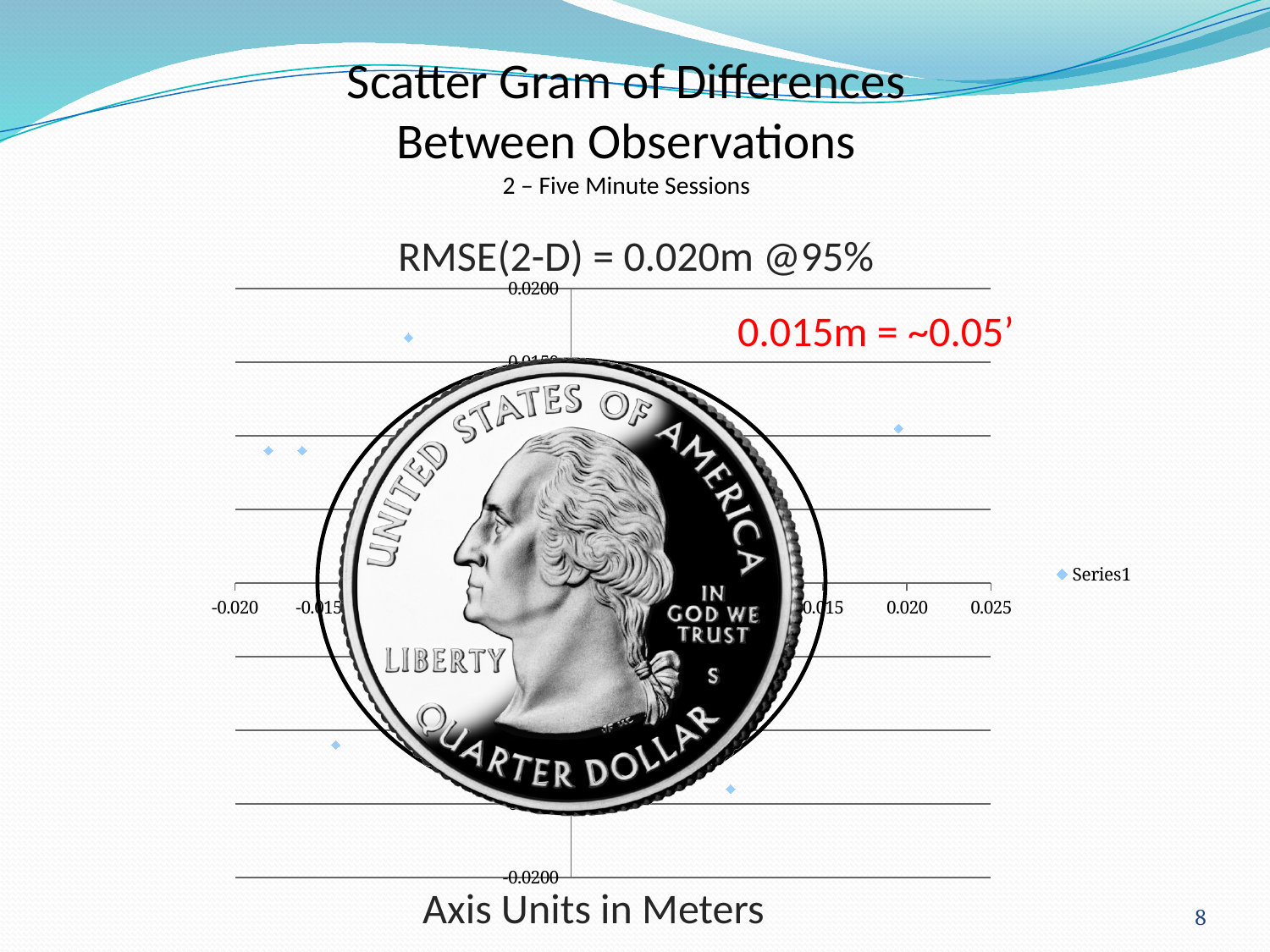
What is the largest value labelled on the chart's x axis? 0.025 How many series does the chart legend list? 1 What is the lowest value labelled on the chart's y axis? -0.0200 What kind of chart is shown on the slide? scatter chart Is the highest plotted point in the chart above or below 0.0150 on the y axis? above What is the highest value labelled on the chart's y axis? 0.0200 Is the lowest plotted point in the chart above or below -0.0200 on the y axis? above What is the title of the chart? RMSE(2-D) = 0.020m @95% Is the rightmost plotted point in the chart to the left or right of 0.015 on the x axis? right What is the smallest value labelled on the chart's x axis? -0.020 What is the name of the series shown in the chart legend? Series1